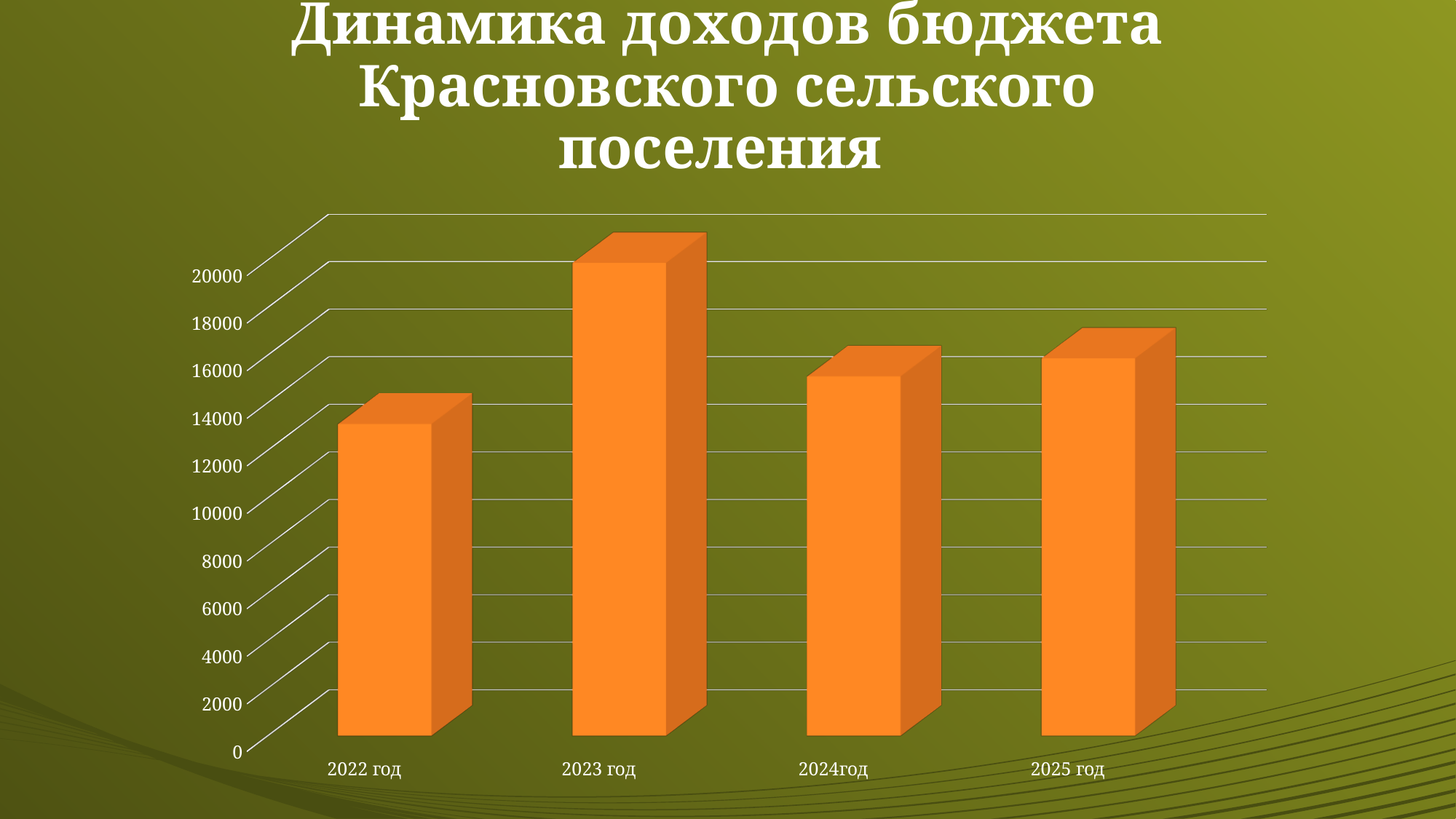
Which is larger, the value for 2023 год or the value for 2022 год? 2023 год Is the value for 2022 год greater or less than 12000? greater Is the value for 2024год greater or less than 14000? greater Is the value for 2023 год greater or less than 18000? greater Does the value rise or fall from 2023 год to 2024год? fall Which year has the lowest budget income in the chart? 2022 год Which is larger, the value for 2025 год or the value for 2024год? 2025 год Which year has the highest budget income in the chart? 2023 год What kind of chart is shown on the slide? bar chart How many categories (years) are shown on the x axis of the chart? 4 What is the title of the chart on the slide? Динамика доходов бюджета Красновского сельского поселения